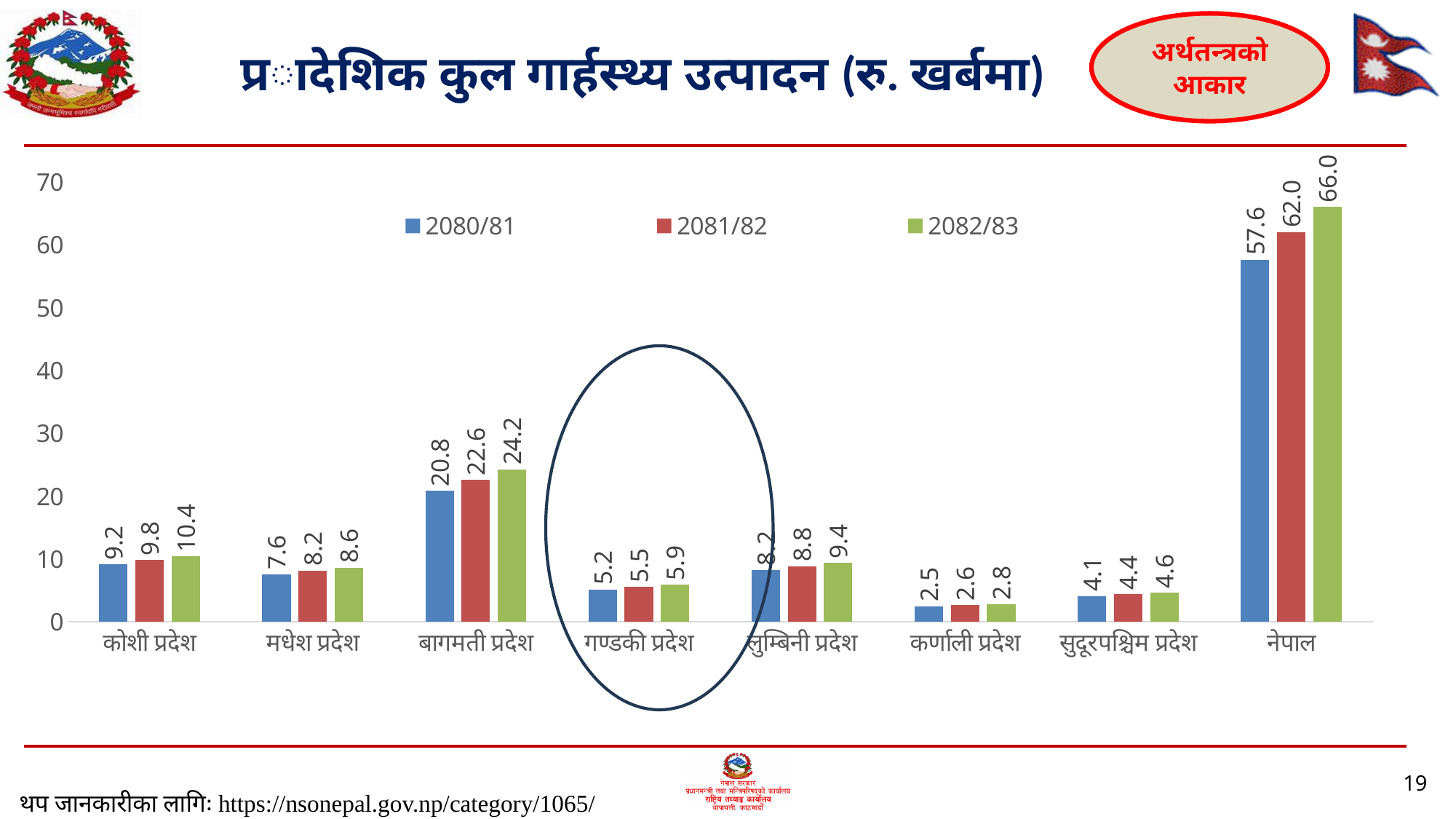
What is the value for नेपाल in the 2081/82 series? 62.0 What is the difference between the 2082/83 and 2080/81 values for नेपाल? 8.4 What is the value for बागमती प्रदेश in the 2082/83 series? 24.2 What is the value for गण्डकी प्रदेश in the 2080/81 series? 5.2 How many series does the legend list? 3 Which is larger: the 2081/82 value for कोशी प्रदेश or the 2081/82 value for लुम्बिनी प्रदेश? कोशी प्रदेश Among the provinces (excluding नेपाल), which category has the highest value in the 2080/81 series? बागमती प्रदेश How many categories are shown on the x axis? 8 Which category on the chart is circled? गण्डकी प्रदेश What kind of chart is shown on the slide? bar chart Which category has the lowest value in the 2082/83 series? कर्णाली प्रदेश Do the values for मधेश प्रदेश rise or fall from 2080/81 to 2082/83? rise